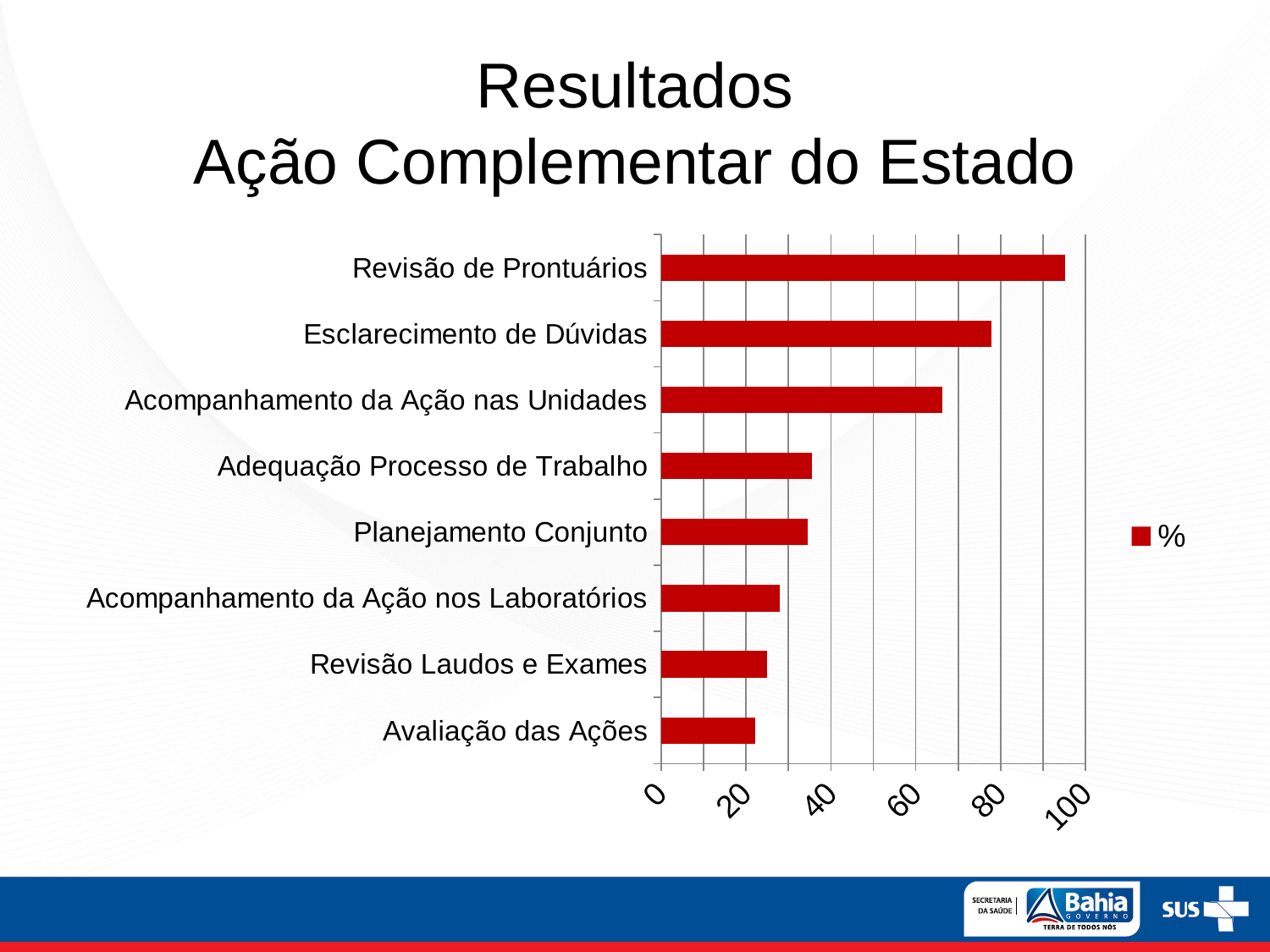
Which category has the highest value? Revisão de Prontuários Is the value for Adequação Processo de Trabalho greater or less than 40? less Which is larger, the value for Planejamento Conjunto or the value for Avaliação das Ações? Planejamento Conjunto How many categories are plotted in the chart? 8 Which category has the lowest value? Avaliação das Ações Which is larger, the value for Esclarecimento de Dúvidas or the value for Acompanhamento da Ação nas Unidades? Esclarecimento de Dúvidas What kind of chart is shown on the slide? bar chart Is the value for Revisão de Prontuários greater or less than 80? greater What is the legend entry shown for the series in the chart? % How many series does the legend list? 1 Is the value for Acompanhamento da Ação nos Laboratórios greater or less than 20? greater